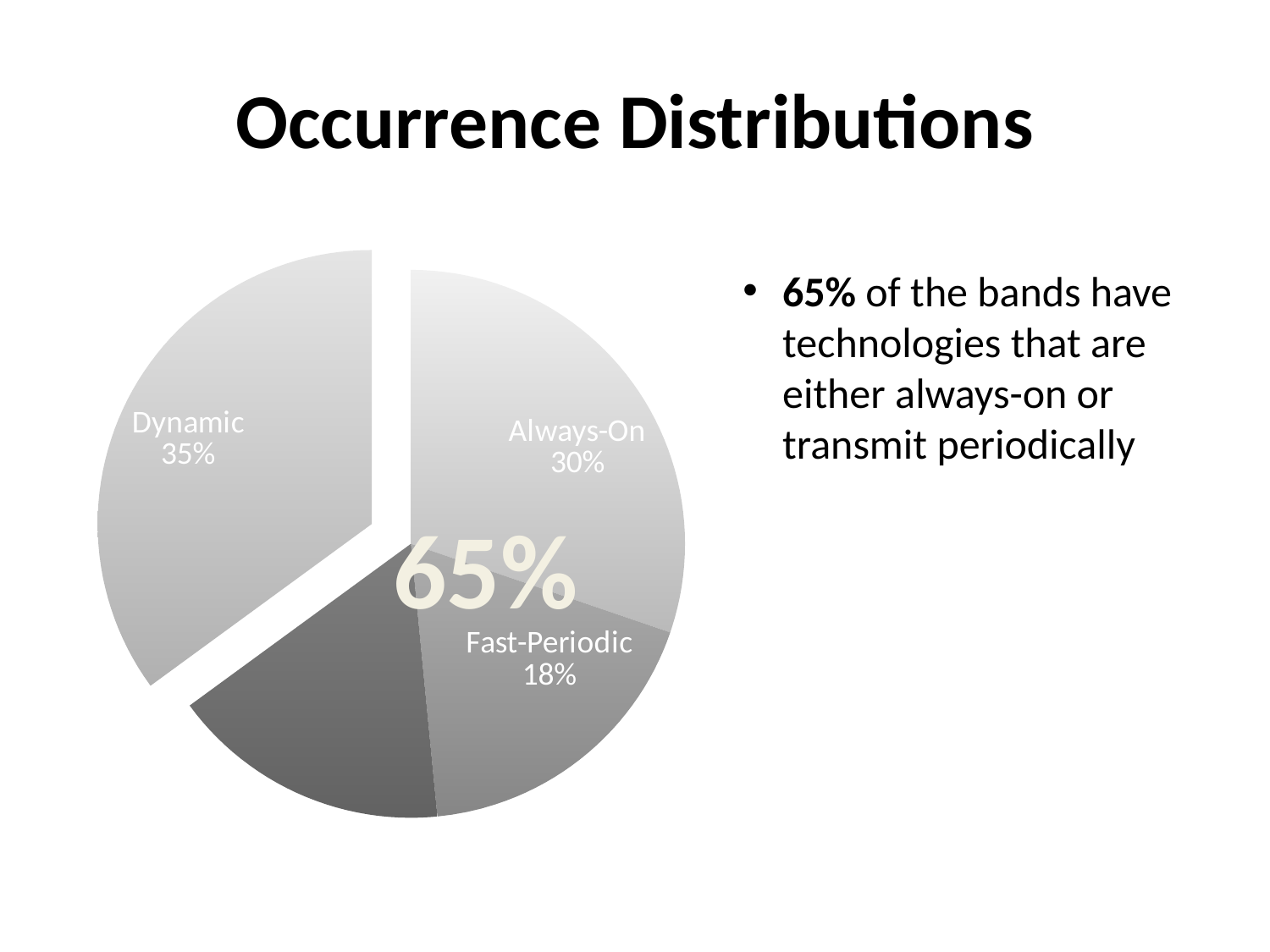
What is the combined share of the Always-On and Fast-Periodic slices? 48% What percentage does the Always-On slice represent? 30% Which is larger, the Always-On slice or the Fast-Periodic slice? Always-On How many slices does the pie chart have? 4 What kind of chart is shown on the slide? pie chart What percentage does the Dynamic slice represent? 35% Which labeled slice of the pie is the largest? Dynamic What is the title of the slide containing the pie chart? Occurrence Distributions What percentage does the Fast-Periodic slice represent? 18% By how many percentage points does Dynamic exceed Always-On? 5 By how many percentage points does Always-On exceed Fast-Periodic? 12 Which is larger, the Dynamic slice or the Always-On slice? Dynamic